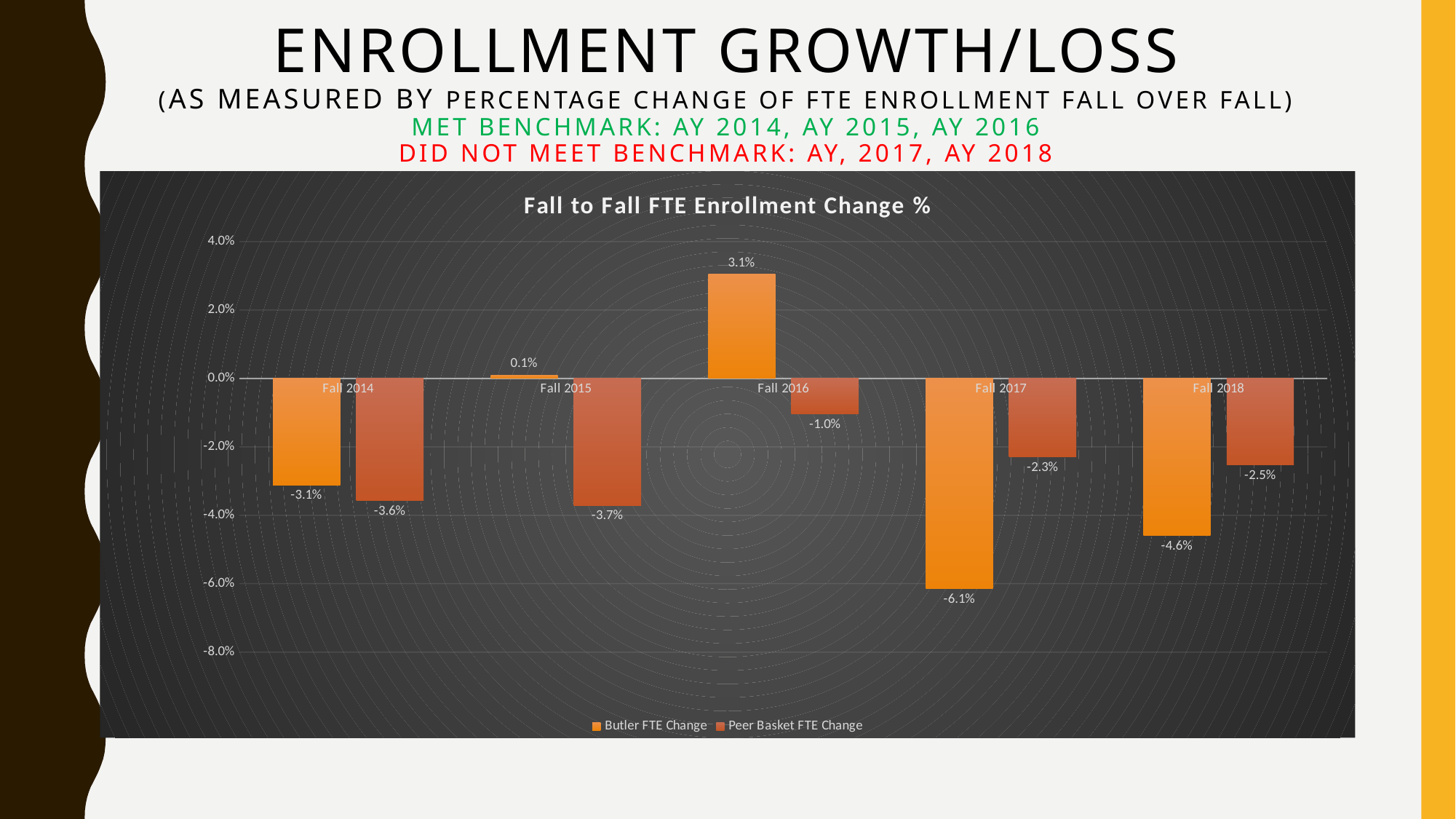
How many series does the chart legend list? 2 What is the Butler FTE Change value for Fall 2016? 3.1% How many Fall periods are shown on the x axis of the chart? 5 What is the Butler FTE Change value for Fall 2017? -6.1% For Fall 2018, which series has the larger value: Butler FTE Change or Peer Basket FTE Change? Peer Basket FTE Change What type of chart is shown on the slide? Bar chart In which Fall does the Butler FTE Change series reach its highest value? Fall 2016 What is the difference between the Butler FTE Change and the Peer Basket FTE Change for Fall 2017? 3.8 percentage points What is the Peer Basket FTE Change value for Fall 2018? -2.5% What is the title of the chart? Fall to Fall FTE Enrollment Change % What is the Peer Basket FTE Change value for Fall 2015? -3.7% In which Fall does the Butler FTE Change series have its lowest value? Fall 2017